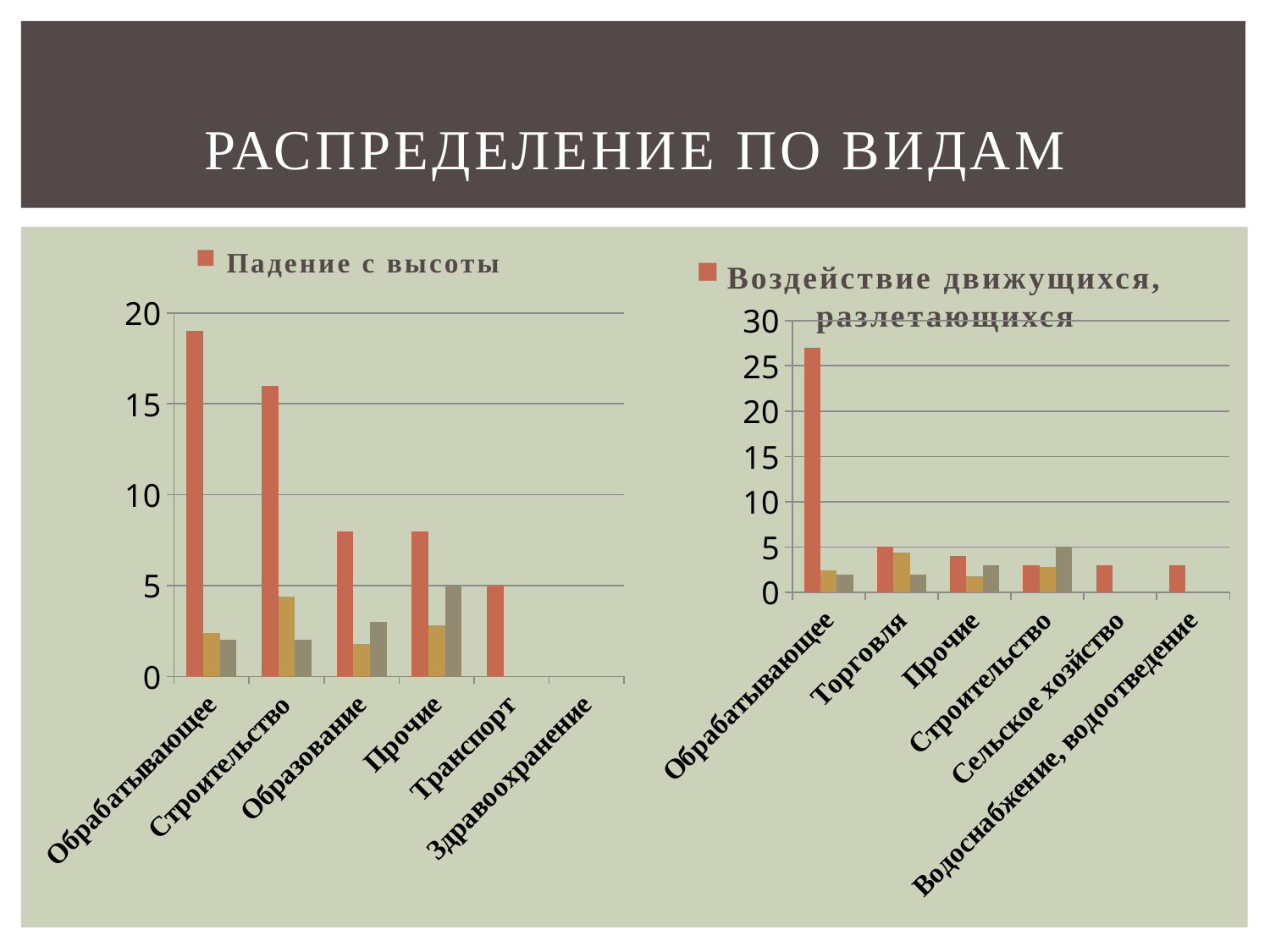
In the right chart 'Воздействие движущихся, разлетающихся', which category has the tallest bar? Обрабатывающее In the right chart 'Воздействие движущихся, разлетающихся', which has the taller red bar: Обрабатывающее or Торговля? Обрабатывающее What is the legend entry shown above the left chart? Падение с высоты In the right chart, do the red bars generally rise or fall from left to right along the x axis? fall In the left chart 'Падение с высоты', is the red bar for Образование greater or less than 10? less In the left chart 'Падение с высоты', which has the taller red bar: Строительство or Образование? Строительство In the right chart 'Воздействие движущихся, разлетающихся', is the red bar for Обрабатывающее greater or less than 25? greater What kind of chart is the left chart titled 'Падение с высоты'? bar chart How many categories are shown on the x axis of the right chart 'Воздействие движущихся, разлетающихся'? 6 In the left chart 'Падение с высоты', which category has the tallest red bar? Обрабатывающее In the left chart 'Падение с высоты', is the red bar for Обрабатывающее greater or less than 15? greater How many categories are shown on the x axis of the left chart 'Падение с высоты'? 6